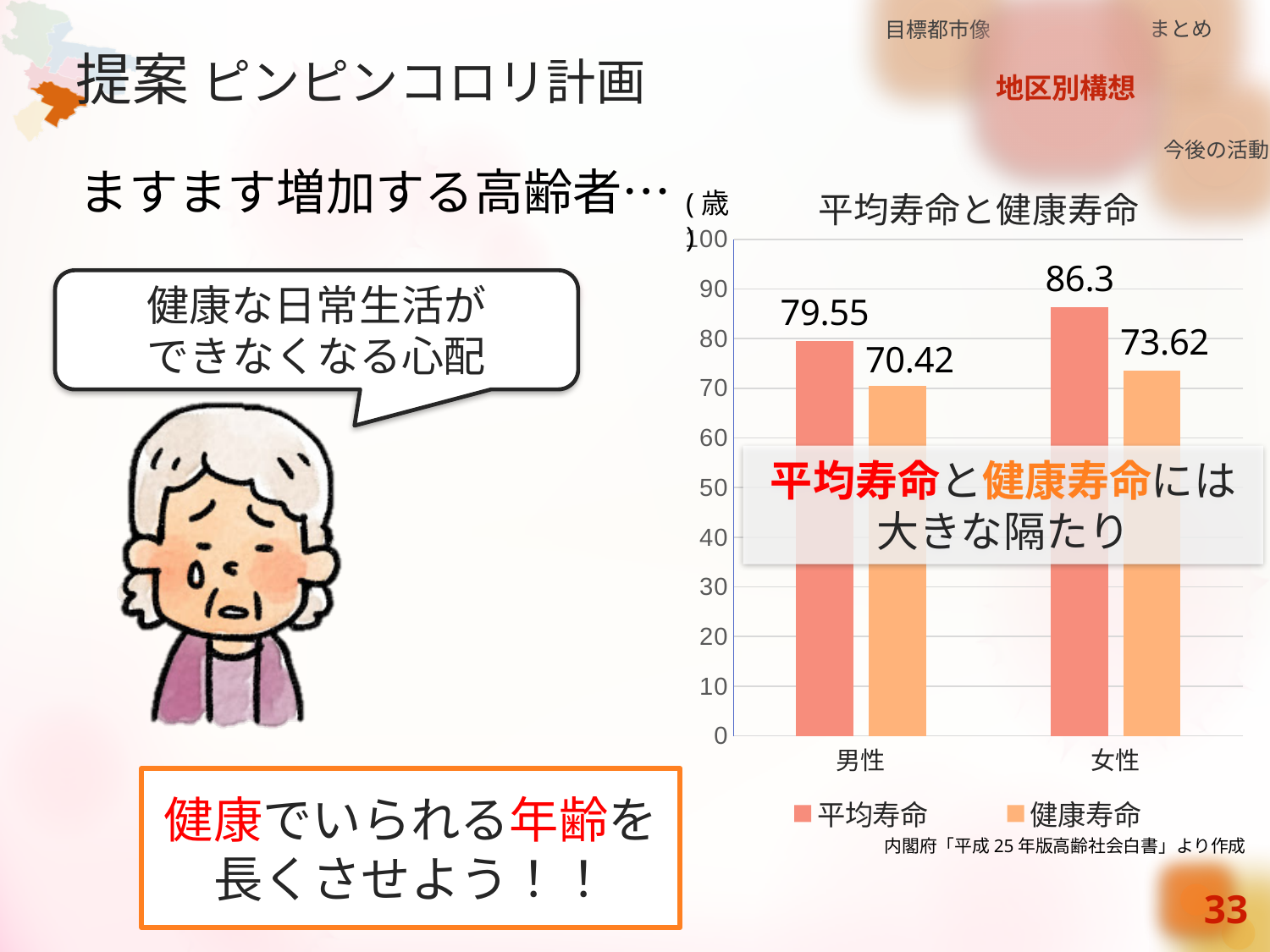
What is the difference between 平均寿命 and 健康寿命 for 女性? 6.68 What kind of chart is shown on the slide? Bar chart What is the 健康寿命 value for 男性? 70.42 How many series does the legend list? 2 Which category has the highest 平均寿命 value? 女性 What is the 平均寿命 value for 女性? 86.3 What is the 平均寿命 value for 男性 in the chart? 79.55 What is the difference between 平均寿命 and 健康寿命 for 男性? 9.13 What is the title of the chart? 平均寿命と健康寿命 Which bar in the chart has the lowest value? 健康寿命 for 男性 Which is larger, the 健康寿命 for 男性 or the 健康寿命 for 女性? 女性 What is the 健康寿命 value for 女性 in the chart? 73.62